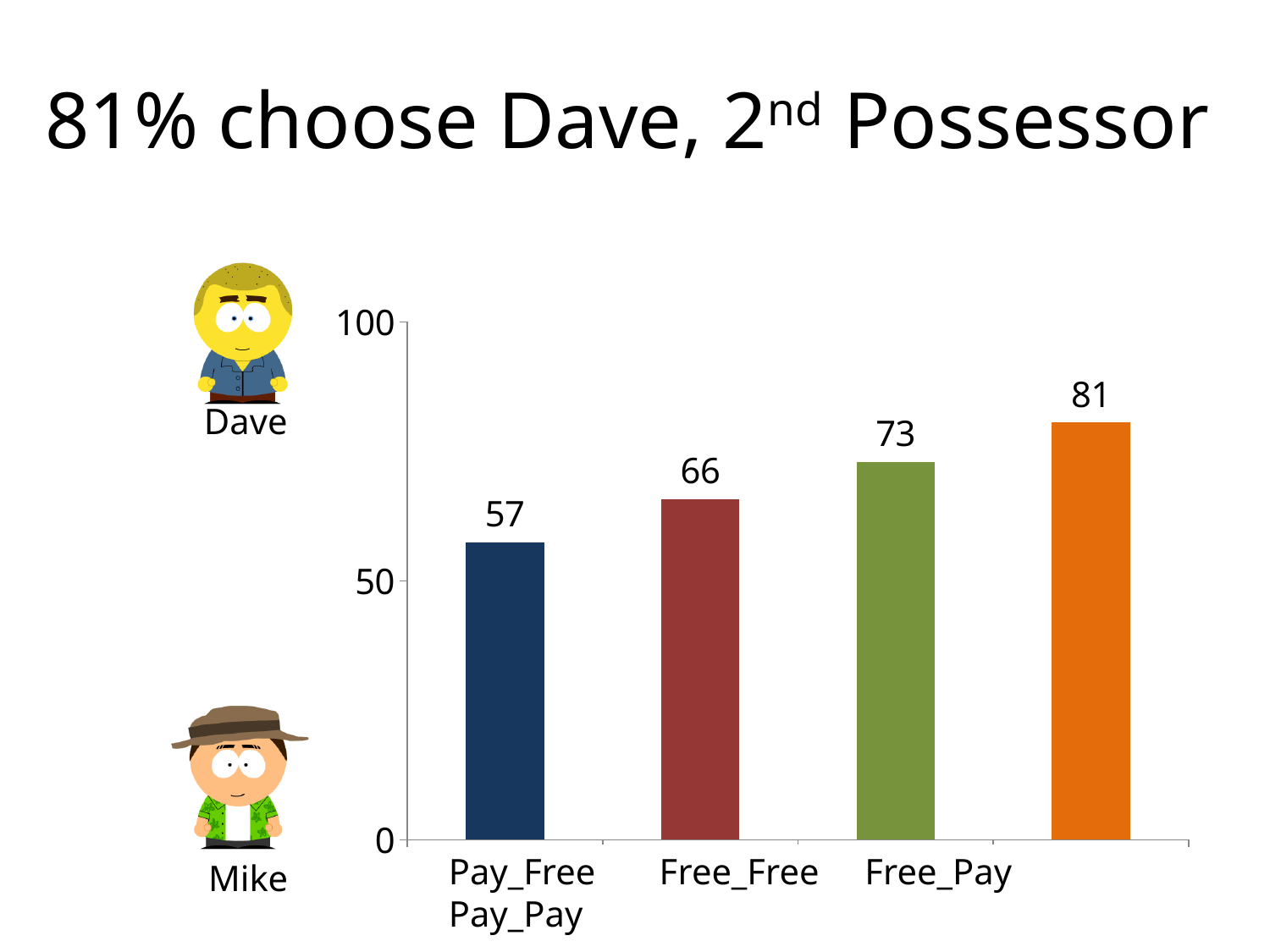
What is the difference between the values for Free_Pay and Pay_Free? 16 Which is larger, the value for Free_Free or the value for Free_Pay? Free_Pay What is the value for Free_Free? 66 Which labelled category has the lowest value? Pay_Free How many bars are plotted on the chart? 4 What kind of chart is shown on the slide? bar chart Is the value for Pay_Free greater or less than 50? greater What is the value for Free_Pay? 73 What is the value of the rightmost (orange) bar? 81 What is the difference between the values for Free_Free and Pay_Free? 9 What is the value for Pay_Free? 57 What is the highest value shown on the chart? 81